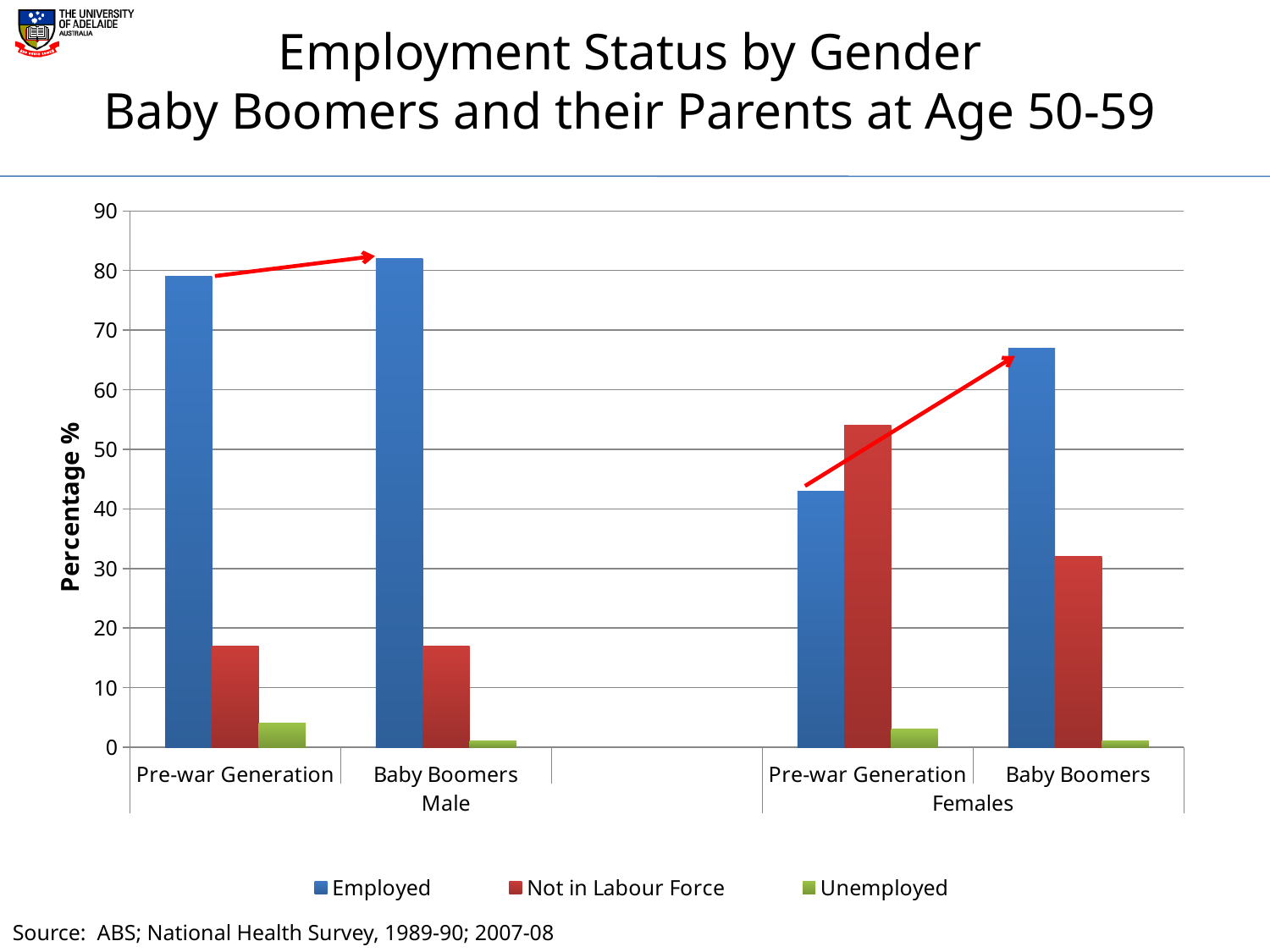
Which group has the lowest Employed value across the chart? Female Pre-war Generation Is the Employed value for Female Pre-war Generation greater or less than 50? less What kind of chart is shown on the slide? bar chart Is the Not in Labour Force value for Female Pre-war Generation greater or less than 50? greater Is the Employed value for Female Baby Boomers greater or less than 60? greater How many series does the legend list? 3 Which is larger for Female Baby Boomers: Employed or Not in Labour Force? Employed Which series is shown in blue in the legend? Employed Which group has the highest Employed value across the chart? Male Baby Boomers Which is larger for Female Pre-war Generation: Employed or Not in Labour Force? Not in Labour Force